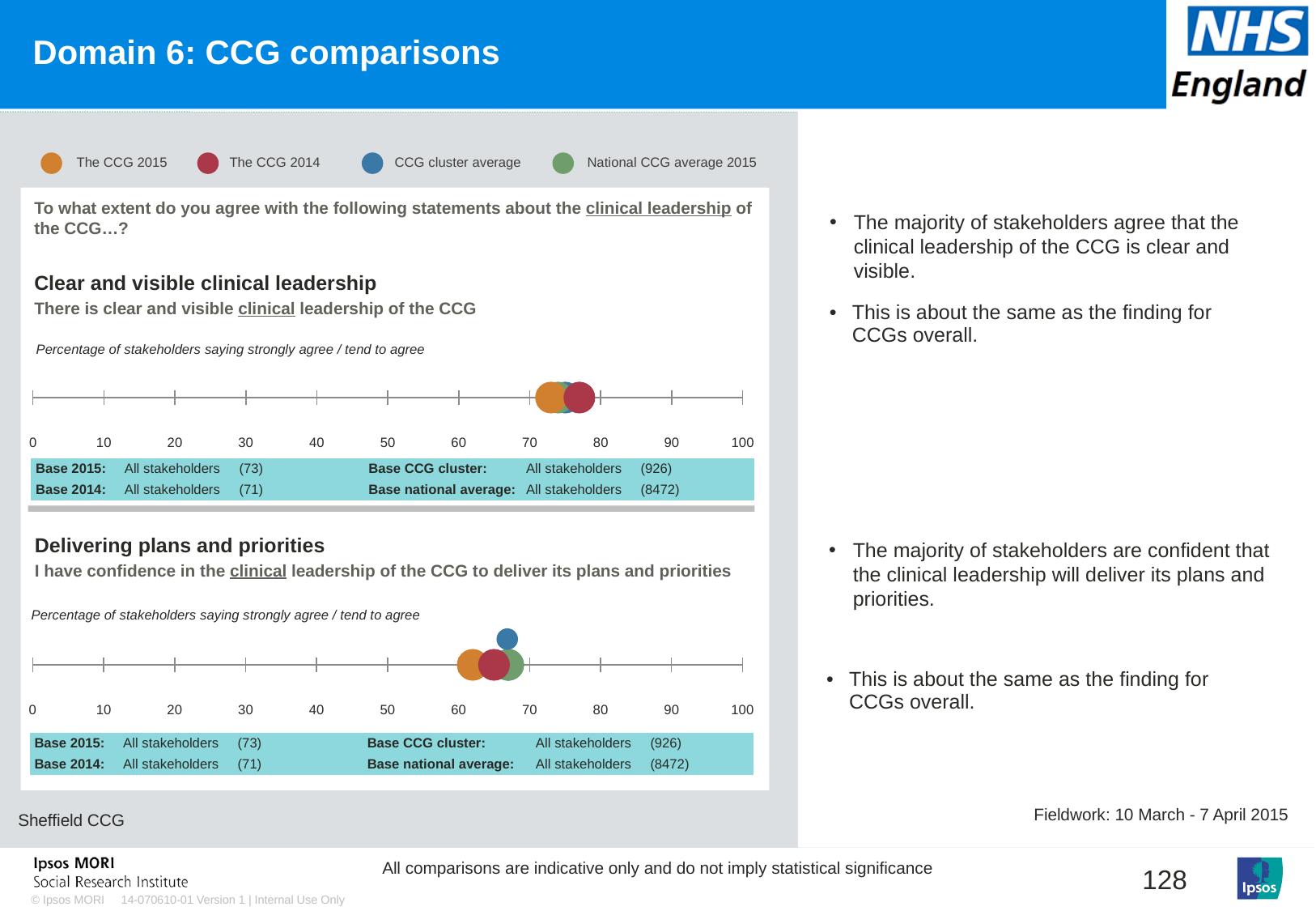
What colour represents The CCG 2015 in the legend? Orange In the 'Clear and visible clinical leadership' chart, is the value for The CCG 2014 greater or less than 80? less How many series does the legend list for the charts on this slide? 4 In the 'Clear and visible clinical leadership' chart, which is larger: the value for The CCG 2015 or The CCG 2014? The CCG 2014 In the 'Delivering plans and priorities' chart, is the value for the CCG cluster average greater or less than 70? less What kind of chart is used for 'Clear and visible clinical leadership'? Dot plot What is the maximum value shown on the x axis of the 'Clear and visible clinical leadership' chart? 100 How many data points are plotted in the 'Delivering plans and priorities' chart? 4 Is the value for The CCG 2015 higher in the 'Clear and visible clinical leadership' chart or in the 'Delivering plans and priorities' chart? Clear and visible clinical leadership In the 'Clear and visible clinical leadership' chart, is the value for The CCG 2015 greater or less than 70? greater